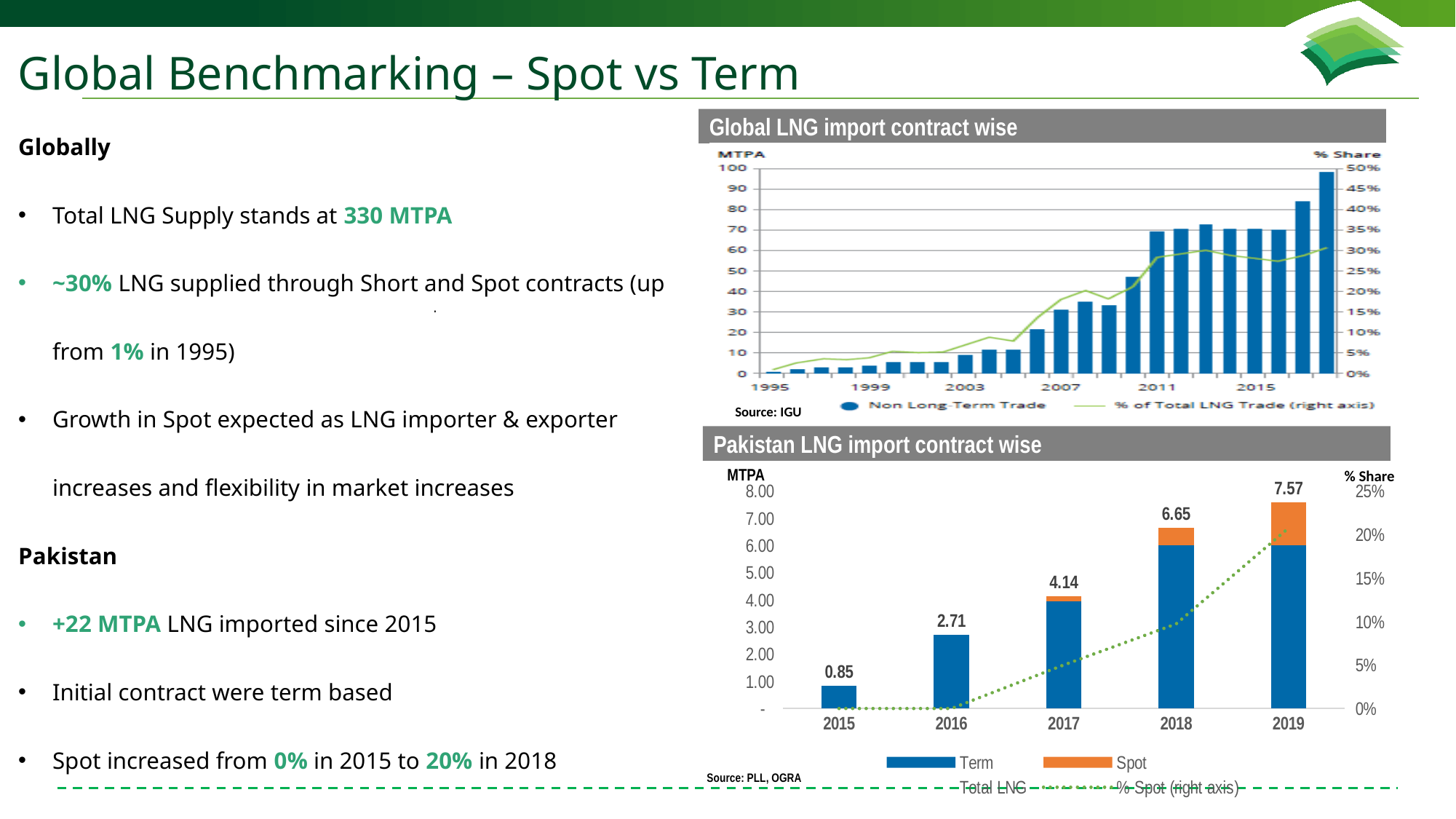
In the Pakistan LNG import contract wise chart, what is the difference between the total LNG values for 2018 and 2017? 2.51 In the Pakistan LNG import contract wise chart, what is the total LNG value labelled for 2017? 4.14 In the Pakistan LNG import contract wise chart, how many entries does the legend list? 4 In the Global LNG import contract wise chart, is the Non Long-Term Trade value for 2011 greater or less than 60 MTPA? greater In the Pakistan LNG import contract wise chart, do the total LNG values rise or fall from 2015 to 2019? rise In the Pakistan LNG import contract wise chart, which year has the lowest total LNG value? 2015 In the Pakistan LNG import contract wise chart, how many years are shown on the x axis? 5 In the Pakistan LNG import contract wise chart, what is the total LNG value labelled for 2019? 7.57 In the Pakistan LNG import contract wise chart, which year has the highest total LNG value? 2019 In the Global LNG import contract wise chart, is the Non Long-Term Trade value for 1999 greater or less than 10 MTPA? less In the Pakistan LNG import contract wise chart, what colour are the Spot bars? orange In the Pakistan LNG import contract wise chart, what is the difference between the total LNG values for 2019 and 2018? 0.92